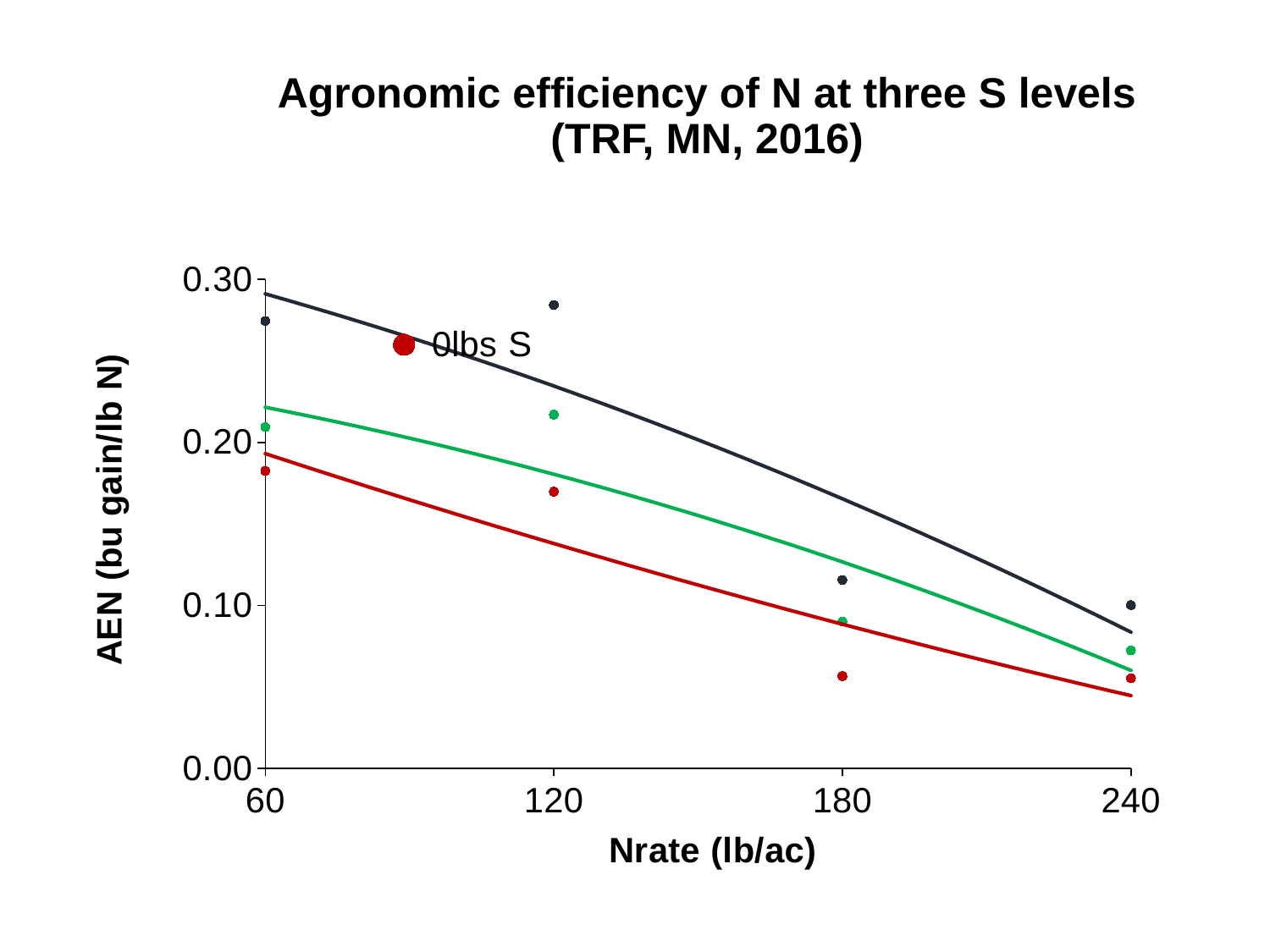
How many series does the legend on the chart label? 1 What is the title of the chart? Agronomic efficiency of N at three S levels (TRF, MN, 2016) For the 0lbs S series, which Nrate has the larger AEN value, 60 or 240? 60 Is the 0lbs S value at Nrate 60 greater or less than 0.20? less Is the dark (top) series value at Nrate 120 greater or less than 0.20? greater Is the 0lbs S series the highest or the lowest of the three fitted curves? lowest What kind of chart is shown on the slide? Scatter plot with fitted curves Is the 0lbs S value at Nrate 180 greater or less than 0.10? less How many fitted curves are plotted on the chart? 3 What is the label of the y axis? AEN (bu gain/lb N) How many N rates are plotted along the x axis? 4 Do the AEN values rise or fall as Nrate increases from 60 to 240? Fall